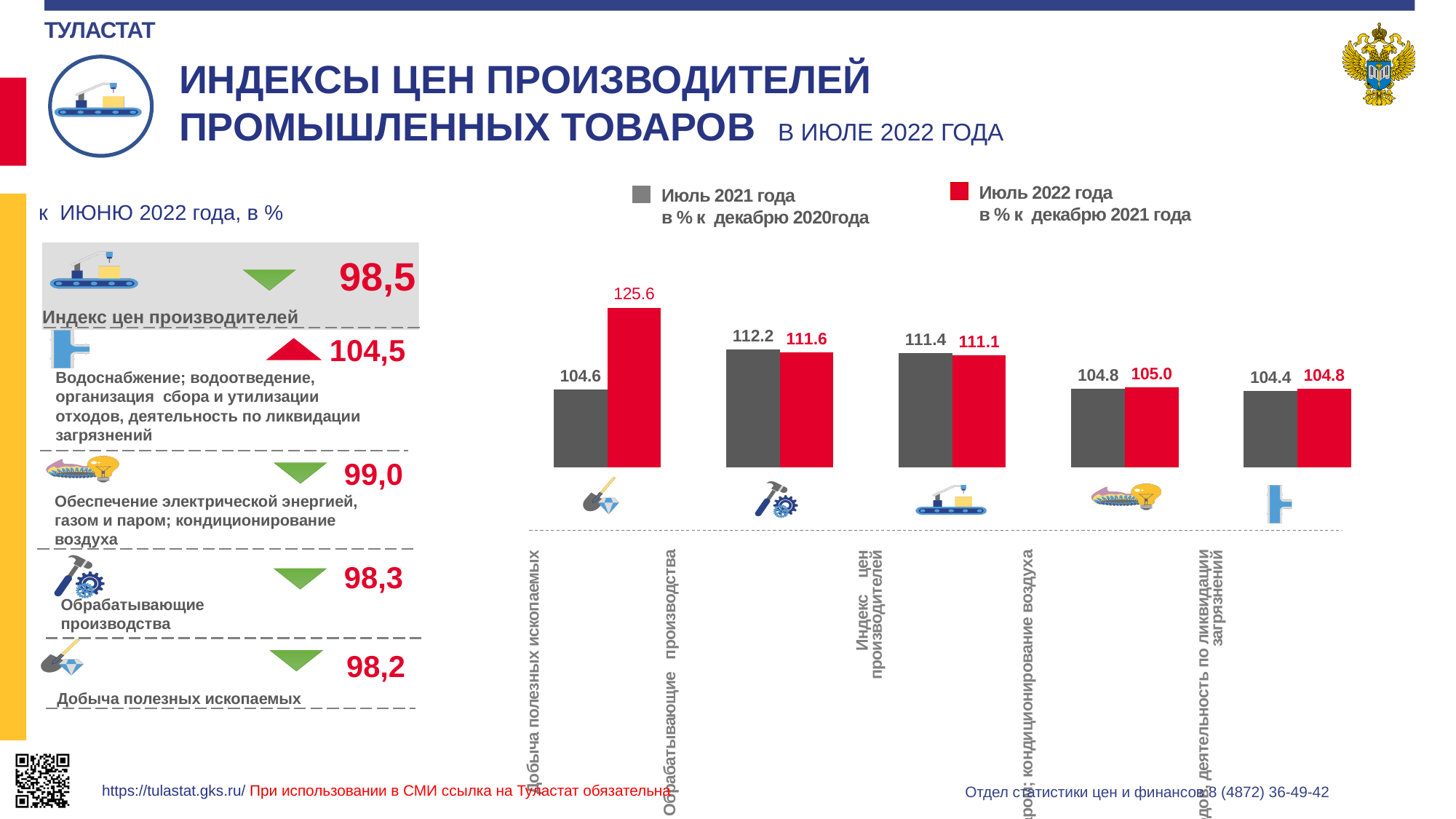
What colour are the bars for the series Июль 2022 года в % к декабрю 2021 года? red What is the value for Обрабатывающие производства in the series Июль 2021 года в % к декабрю 2020 года? 112.2 What is the value for Добыча полезных ископаемых in the series Июль 2021 года в % к декабрю 2020 года? 104.6 Which category has the highest value in the series Июль 2022 года в % к декабрю 2021 года? Добыча полезных ископаемых What is the value for Добыча полезных ископаемых in the series Июль 2022 года в % к декабрю 2021 года? 125.6 What kind of chart is shown on the slide? bar chart Which category has the lowest value in the series Июль 2021 года в % к декабрю 2020 года? Водоснабжение; водоотведение, организация сбора и утилизации отходов, деятельность по ликвидации загрязнений What is the difference between the two series values for Добыча полезных ископаемых? 21.0 For Обрабатывающие производства, which series has the larger value: Июль 2021 года or Июль 2022 года? Июль 2021 года What is the value for Индекс цен производителей in the series Июль 2022 года в % к декабрю 2021 года? 111.1 How many series does the chart legend list? 2 How many categories are plotted in the bar chart? 5